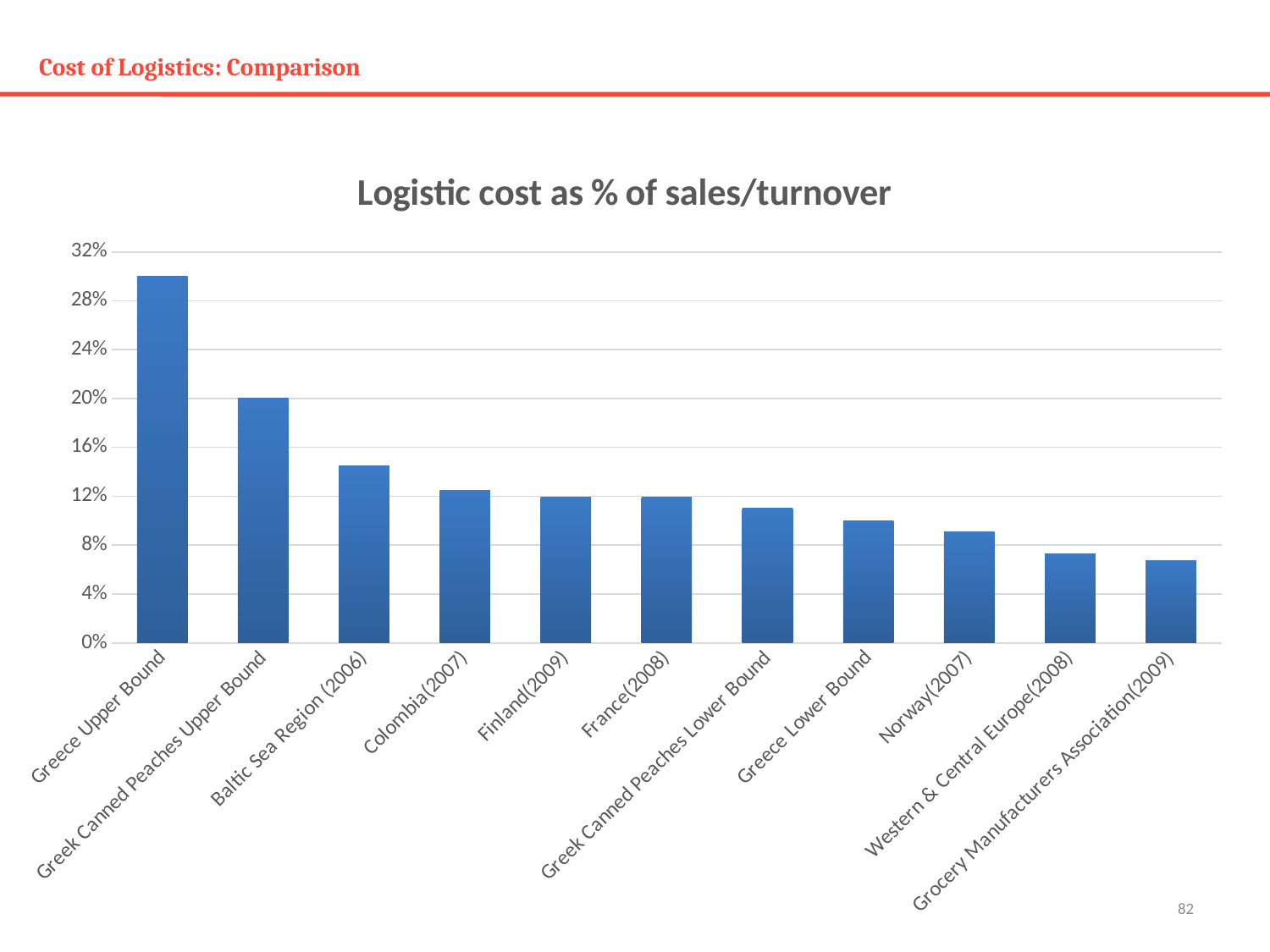
What is the title of the chart? Logistic cost as % of sales/turnover Which is larger, the value for Greece Upper Bound or the value for Greece Lower Bound? Greece Upper Bound Do the values generally rise or fall from left to right along the x axis? Fall Which category has the highest logistic cost as % of sales/turnover? Greece Upper Bound Is the value for Baltic Sea Region (2006) greater or less than 12%? greater Is the value for Western & Central Europe(2008) greater or less than 8%? less Which category has the lowest logistic cost as % of sales/turnover? Grocery Manufacturers Association(2009) How many categories (bars) are shown in the chart? 11 What type of chart is shown on the slide? Bar chart Is the value for Norway(2007) greater or less than 8%? greater What is the logistic cost as % of sales/turnover for Greek Canned Peaches Upper Bound? 20%